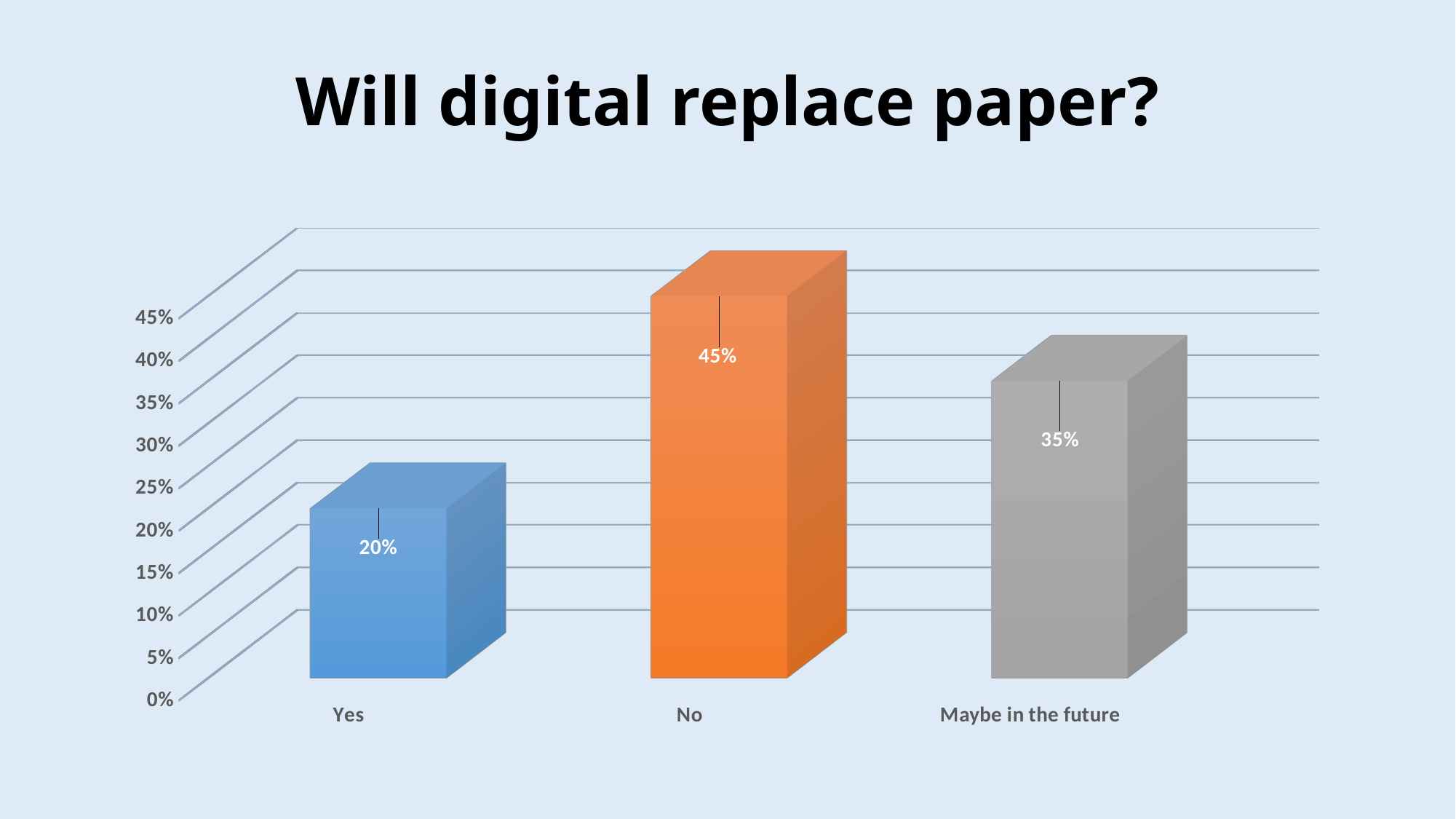
What is the difference between the values for "No" and "Maybe in the future"? 10% Which category has the highest value? No What is the value for "Maybe in the future"? 35% What is the difference between the values for "No" and "Yes"? 25% Is the value for "Maybe in the future" greater or less than 30%? greater What is the title of the slide? Will digital replace paper? Which category has the lowest value? Yes What is the value for "No"? 45% What is the value for "Yes"? 20% What kind of chart is shown on the slide? Bar chart How many categories are shown in the chart? 3 Which is larger, the value for "Maybe in the future" or the value for "Yes"? Maybe in the future